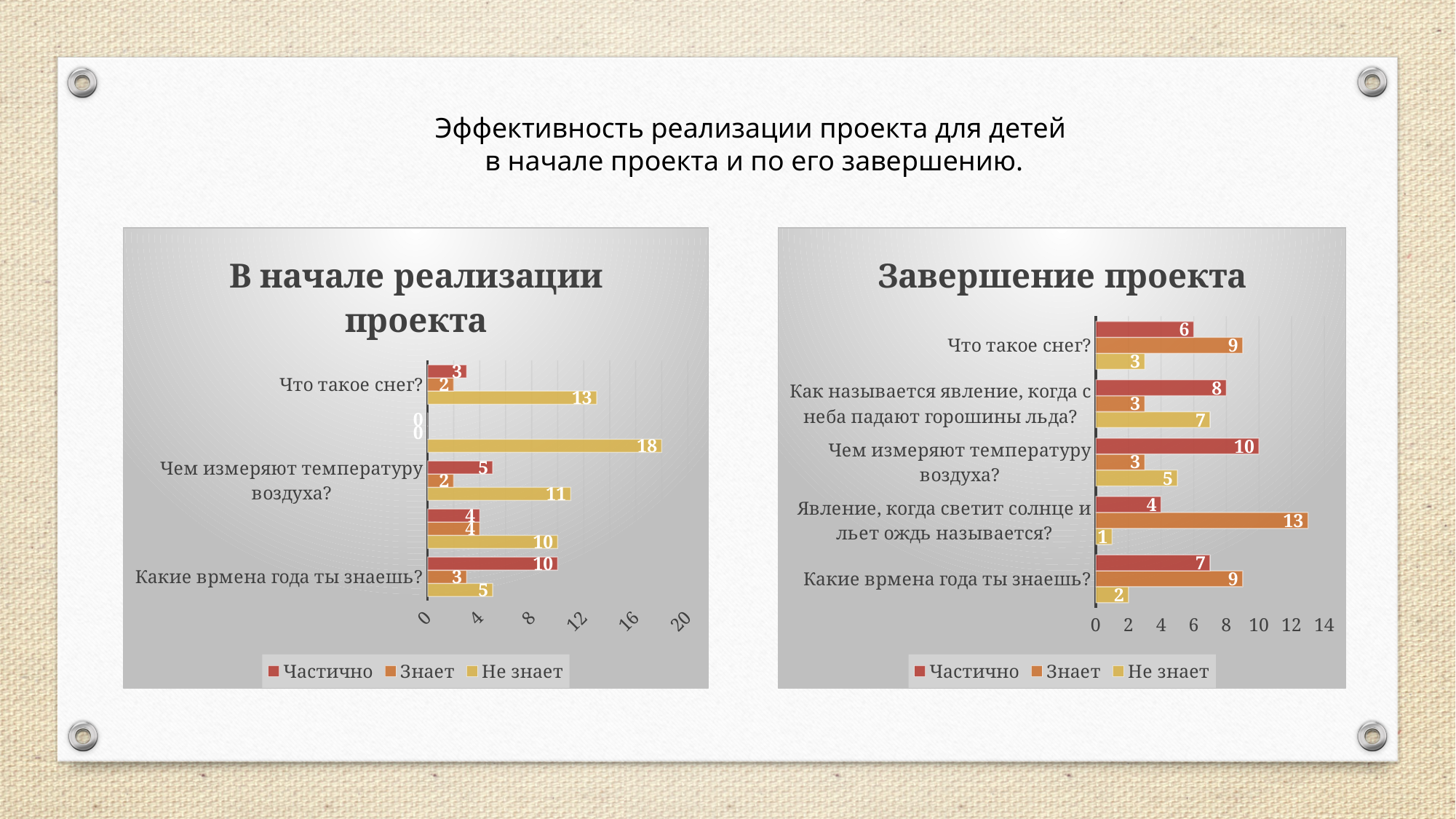
On the chart titled "Завершение проекта", what is the difference between the "Знает" and "Не знает" values for "Какие врмена года ты знаешь?"? 7 How many categories are shown on the chart titled "Завершение проекта"? 5 On the chart titled "Завершение проекта", what is the value of "Знает" for "Что такое снег?"? 9 How many series does the legend list on the chart titled "Завершение проекта"? 3 On the chart titled "Завершение проекта", which category has the lowest "Не знает" value? Явление, когда светит солнце и льет ождь называется? On the chart titled "Завершение проекта", what is the value of "Частично" for "Чем измеряют температуру воздуха?"? 10 On the chart titled "В начале реализации проекта", what is the value of "Частично" for "Какие врмена года ты знаешь?"? 10 What is the highest tick value on the x axis of the chart titled "Завершение проекта"? 14 On the chart titled "В начале реализации проекта", what is the value of "Не знает" for "Что такое снег?"? 13 What kind of chart is the chart titled "В начале реализации проекта"? Bar chart On the chart titled "Завершение проекта", which category has the highest "Знает" value? Явление, когда светит солнце и льет ождь называется? On the chart titled "В начале реализации проекта", which is larger for "Чем измеряют температуру воздуха?": "Частично" or "Не знает"? Не знает